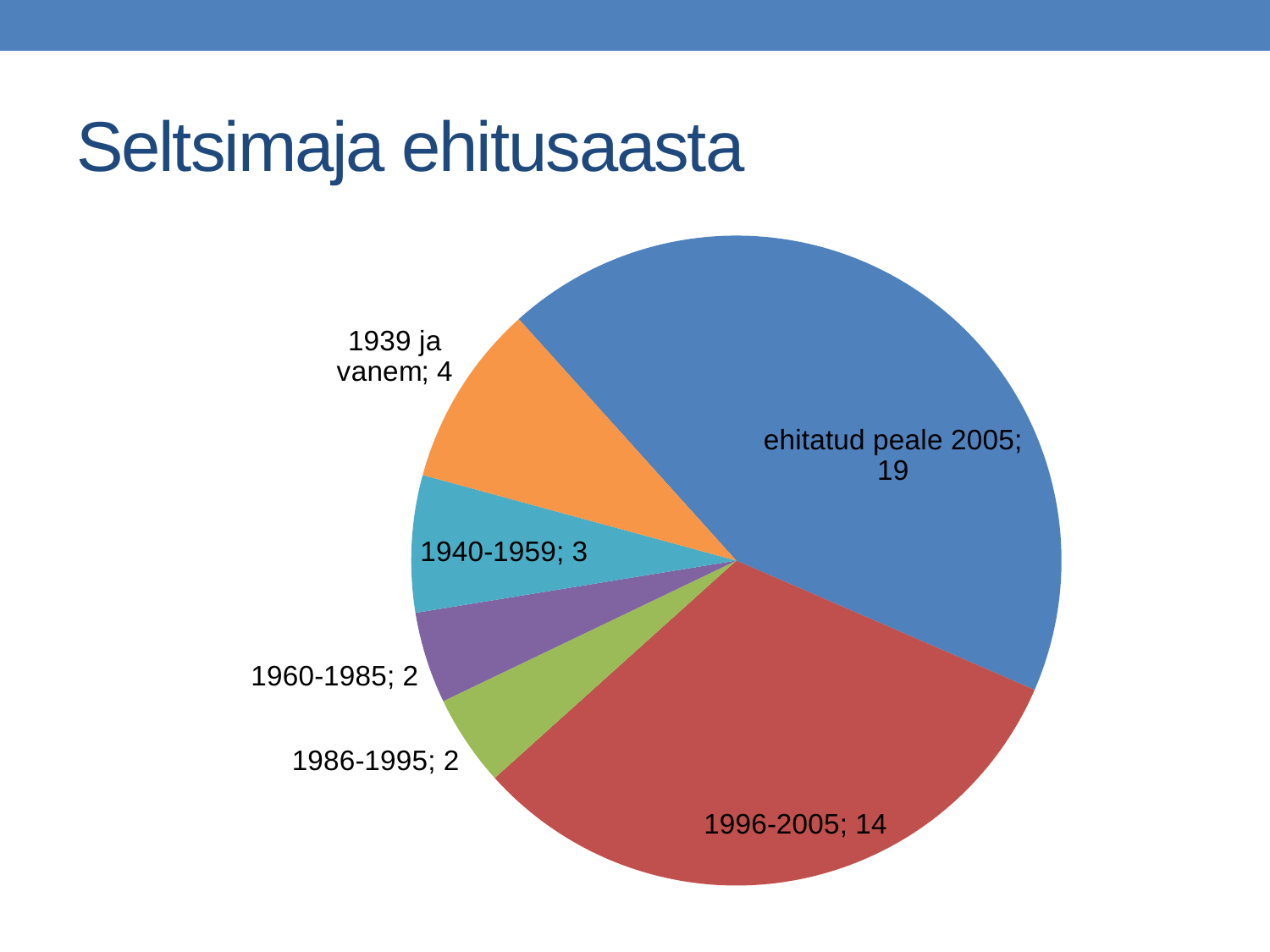
How many slices does the pie chart have? 6 What is the value for the 1996-2005 slice? 14 What is the value for the 1940-1959 slice? 3 Which category has the largest slice of the pie? ehitatud peale 2005 What share of the pie does the 'ehitatud peale 2005' slice represent? 43.2% What is the value for the 1939 ja vanem slice? 4 What is the total of all the slice values in the pie chart? 44 What type of chart is shown on the slide? pie chart What is the title of the slide containing the pie chart? Seltsimaja ehitusaasta What is the difference between the values for 'ehitatud peale 2005' and 1996-2005? 5 Which is larger, the value for 1939 ja vanem or the value for 1940-1959? 1939 ja vanem What is the value for the slice labelled 'ehitatud peale 2005'? 19